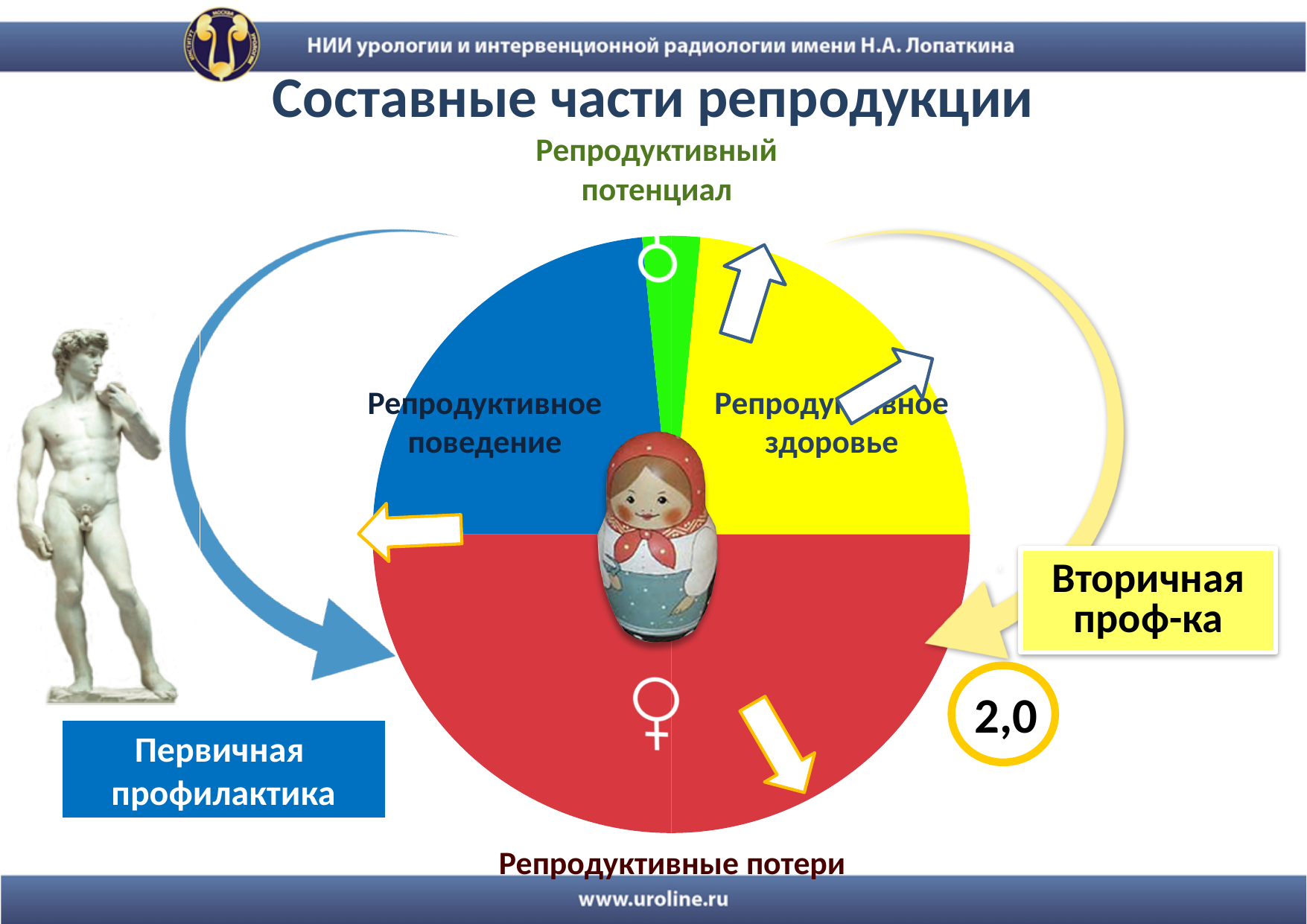
Which slice is larger: Репродуктивные потери or Репродуктивный потенциал? Репродуктивные потери Which slice is larger: Репродуктивные потери or Репродуктивное поведение? Репродуктивные потери Which slice is larger: Репродуктивное здоровье or Репродуктивный потенциал? Репродуктивное здоровье How many slices does the pie chart have? 4 Which slice of the pie chart is the largest? Репродуктивные потери Which slice of the pie chart is the smallest? Репродуктивный потенциал What is the title of the slide containing the pie chart? Составные части репродукции What colour is the slice labelled Репродуктивное поведение? blue What kind of chart is shown on the slide? pie chart